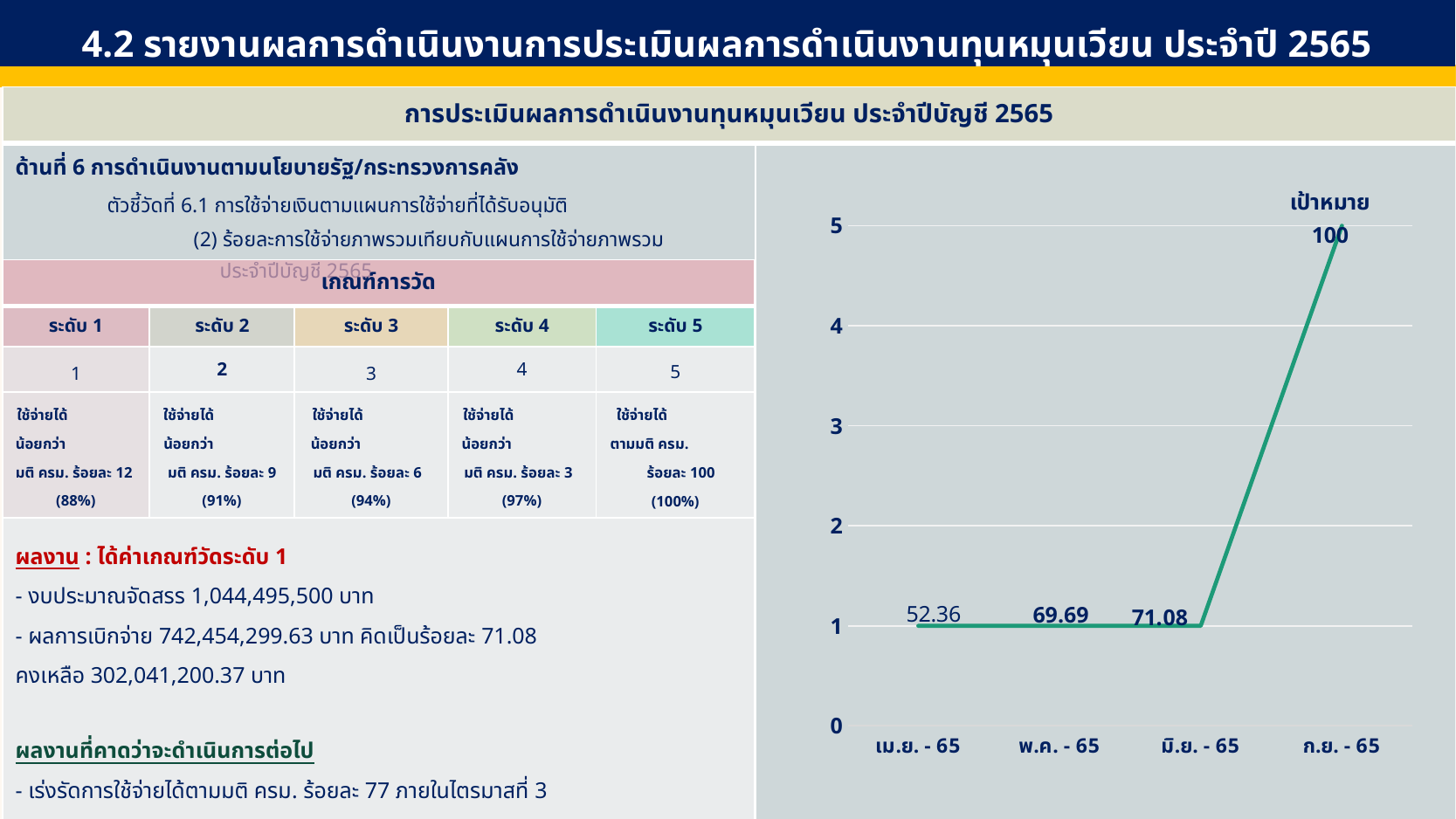
Do the data labels on the line chart rise or fall from เม.ย. - 65 to ก.ย. - 65? rise What kind of chart is shown on the right side of the slide? line chart What is the data label for พ.ค. - 65 on the line chart? 69.69 Which x-axis category has the highest data label on the line chart? ก.ย. - 65 What word is written above the 100 data label at the top right of the line chart? เป้าหมาย Which has the larger data label on the line chart, พ.ค. - 65 or เม.ย. - 65? พ.ค. - 65 Which x-axis category has the lowest data label on the line chart? เม.ย. - 65 What is the data label for เม.ย. - 65 on the line chart? 52.36 What is the data label for ก.ย. - 65 on the line chart? 100 How many points are plotted along the x axis of the line chart? 4 What is the data label for มิ.ย. - 65 on the line chart? 71.08 What is the difference between the data labels for ก.ย. - 65 and มิ.ย. - 65 on the line chart? 28.92